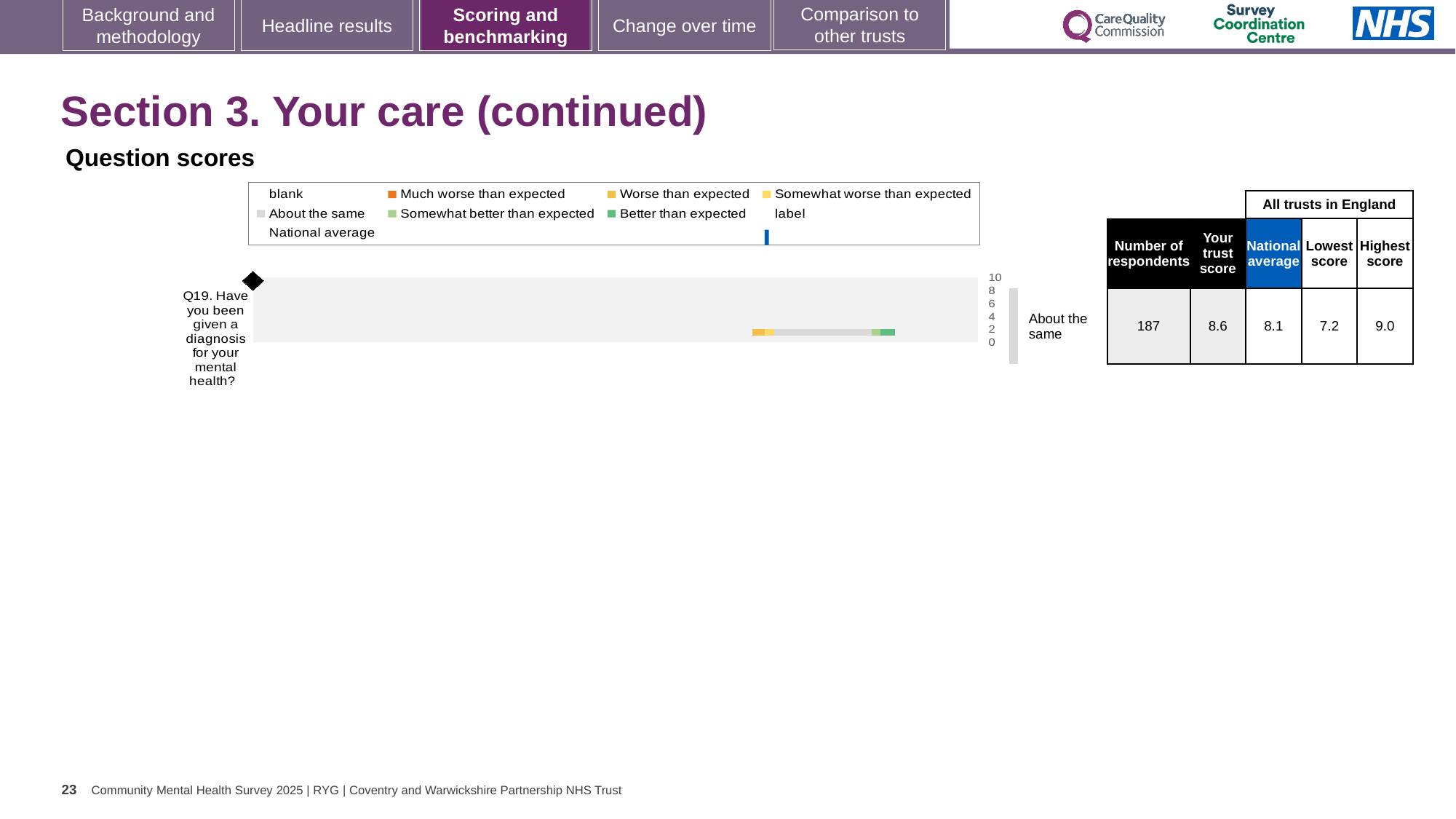
How many questions are plotted on the chart? 1 Which question is plotted on the chart? Q19. Have you been given a diagnosis for your mental health? How many respondents answered Q19? 187 What benchmark category is shown for Q19 next to the chart? About the same Which is larger for Q19: the trust score or the national average? the trust score What is the national average score for Q19? 8.1 What is the highest score among all trusts in England for Q19? 9.0 What is the trust score for Q19 (Have you been given a diagnosis for your mental health?)? 8.6 What is the difference between the trust score and the national average for Q19? 0.5 What is the lowest score among all trusts in England for Q19? 7.2 What is the difference between the highest and lowest scores for Q19 across all trusts in England? 1.8 What kind of chart is used to show the Q19 question score? bar chart